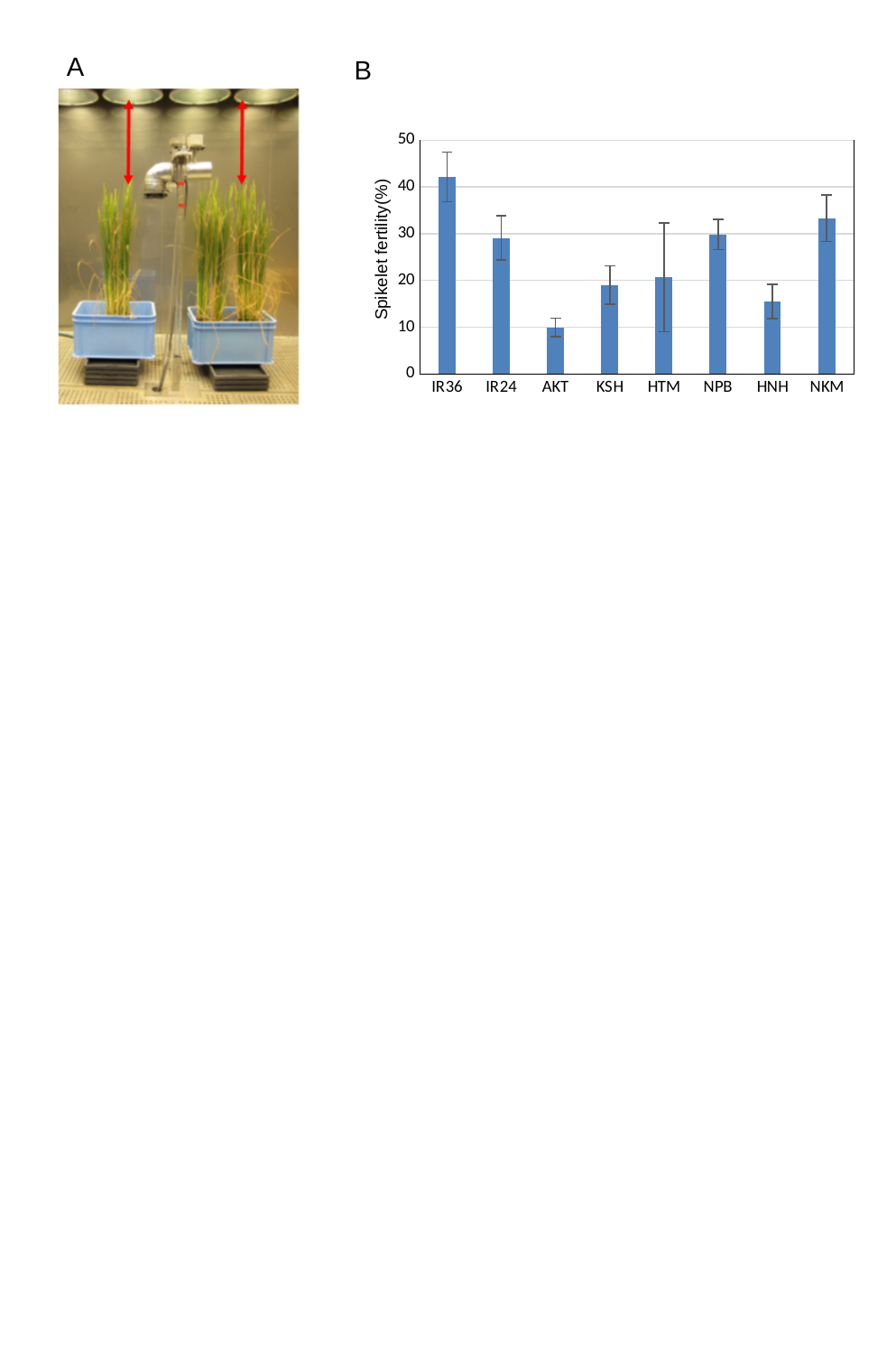
In chart B, which category has the lowest spikelet fertility? AKT In chart B, is the value for NPB greater or less than 20? greater In chart B, which has the larger spikelet fertility, IR36 or NKM? IR36 In chart B, which has the larger spikelet fertility, HNH or AKT? HNH In chart B, is the value for IR36 greater or less than 30? greater In chart B, is the value for AKT greater or less than 20? less In chart B, which category has the highest spikelet fertility? IR36 What kind of chart is chart B? bar chart In chart B, how many categories are shown on the x axis? 8 What is the y-axis label of chart B? Spikelet fertility(%)